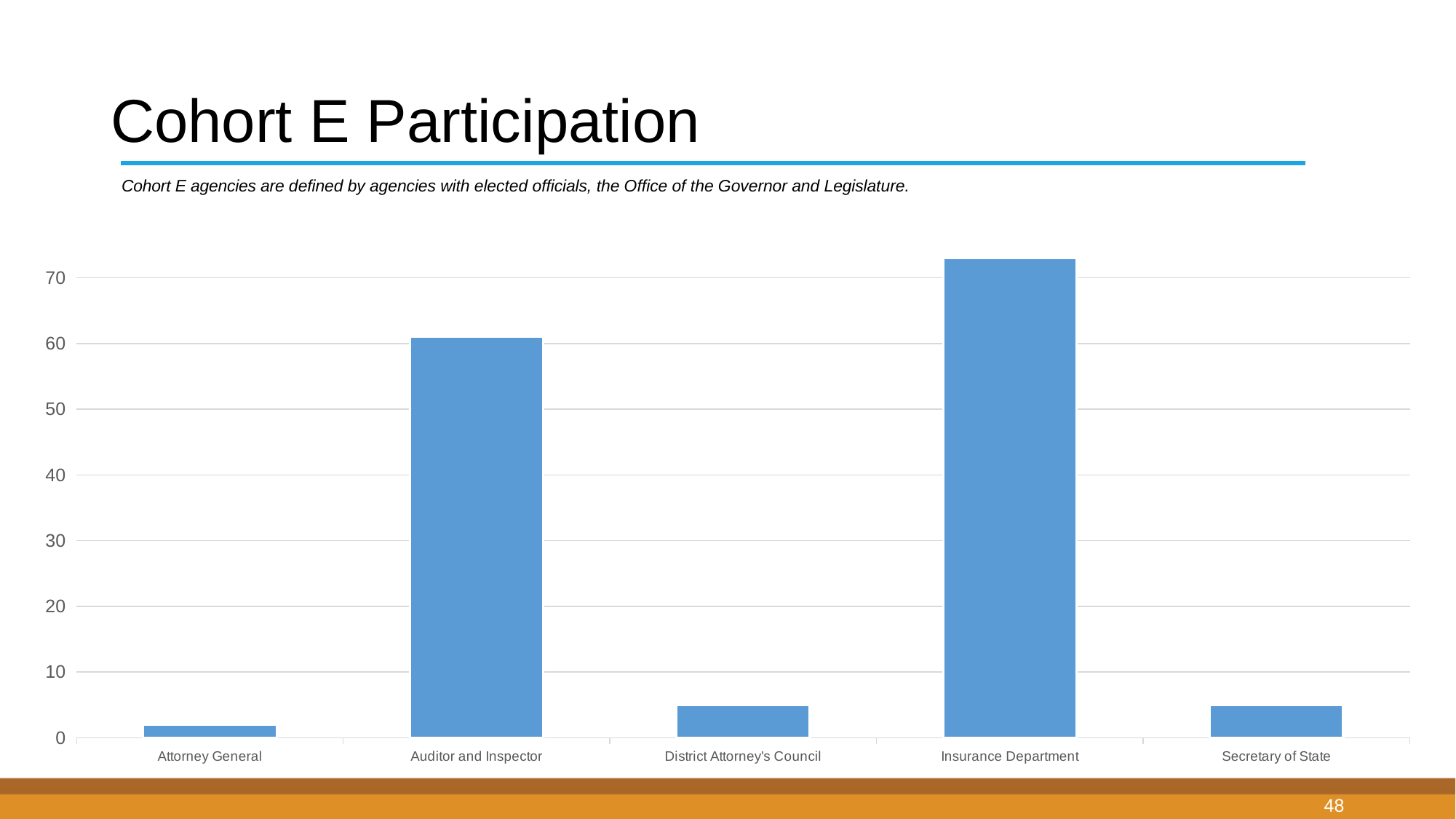
Is the value for Secretary of State greater or less than 10? less Which is larger, the value for Attorney General or the value for Auditor and Inspector? Auditor and Inspector What is the title of the slide containing the chart? Cohort E Participation Which agency has the highest bar in the chart? Insurance Department How many agencies are shown on the x axis of the chart? 5 Is the value for District Attorney's Council greater or less than 10? less Is the value for Insurance Department greater or less than 70? greater Which is larger, the value for Insurance Department or the value for Auditor and Inspector? Insurance Department Which agency has the lowest bar in the chart? Attorney General What kind of chart is shown on the slide? bar chart